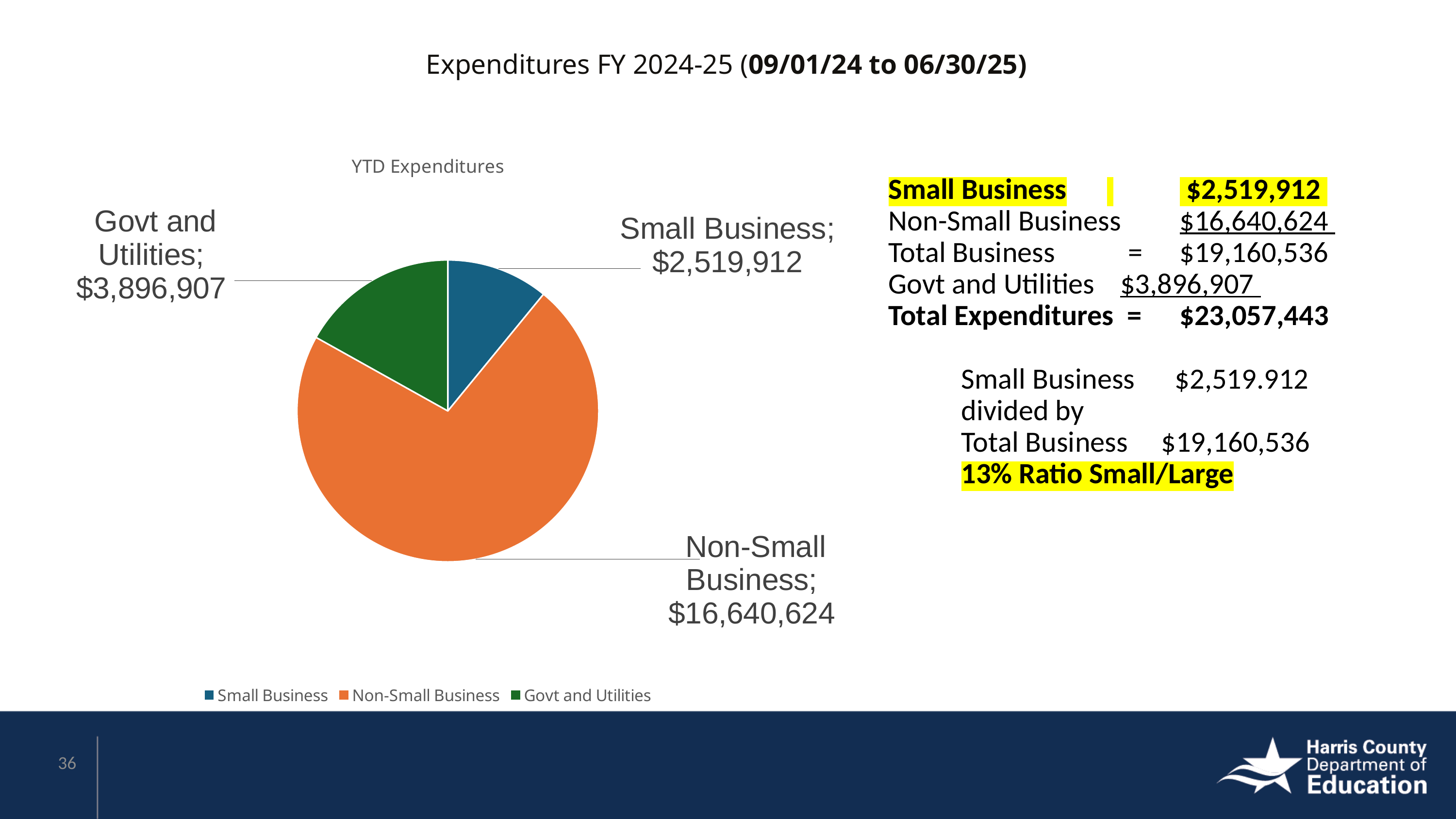
What is the value of the Small Business slice in the YTD Expenditures pie chart? $2,519,912 Which category has the smallest slice in the YTD Expenditures pie chart? Small Business In the YTD Expenditures pie chart, which is larger: Govt and Utilities or Small Business? Govt and Utilities What is the difference between the Non-Small Business and Govt and Utilities values in the YTD Expenditures pie chart? $12,743,717 What kind of chart is used to show YTD Expenditures? Pie chart What is the value of the Non-Small Business slice in the YTD Expenditures pie chart? $16,640,624 Which category has the largest slice in the YTD Expenditures pie chart? Non-Small Business What is the total of all three slices in the YTD Expenditures pie chart? $23,057,443 What is the value of the Govt and Utilities slice in the YTD Expenditures pie chart? $3,896,907 What is the difference between the Govt and Utilities and Small Business values in the YTD Expenditures pie chart? $1,376,995 How many slices does the YTD Expenditures pie chart have? 3 How many entries does the legend of the YTD Expenditures chart list? 3